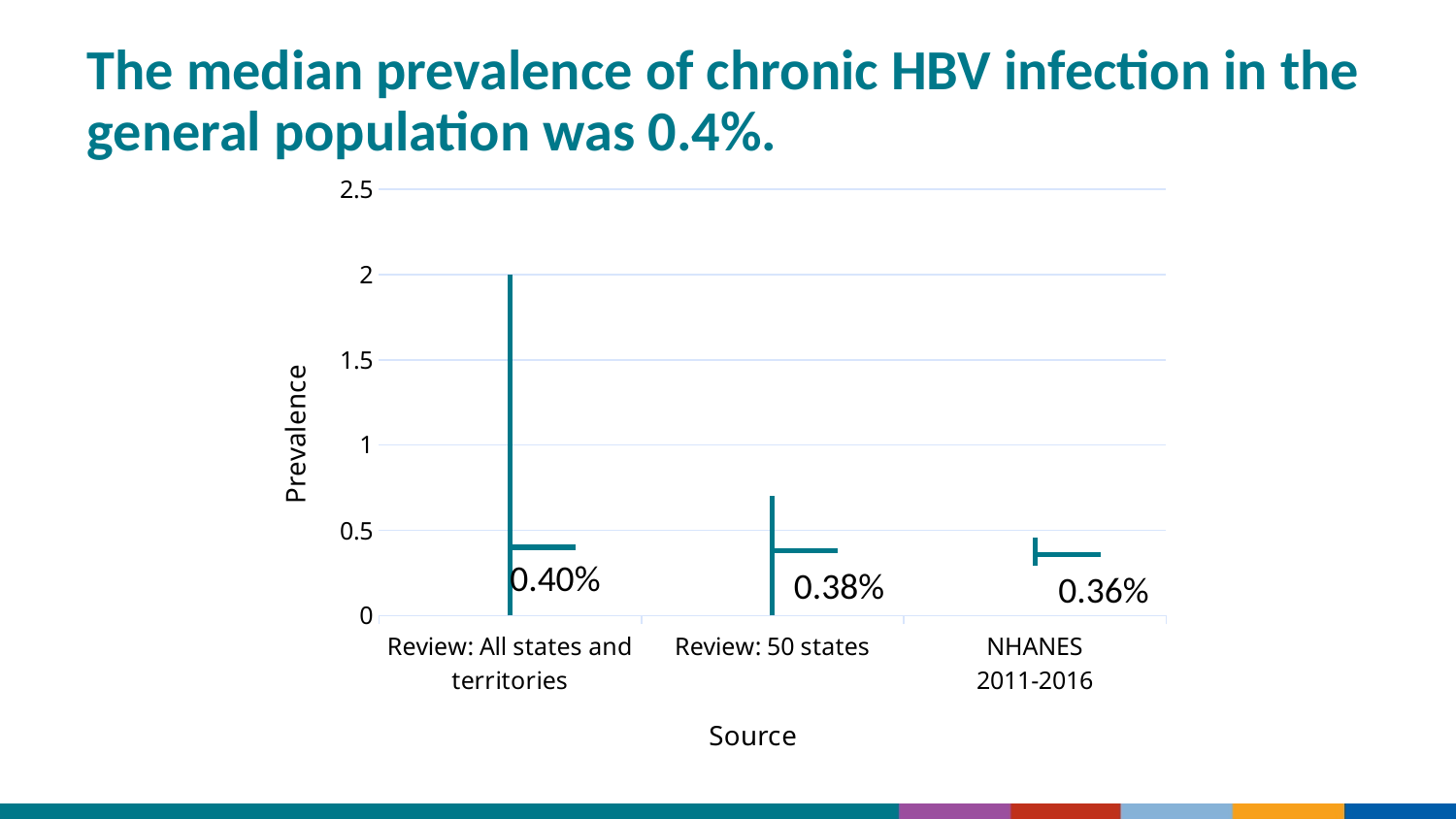
Which source has the lowest labelled median prevalence? NHANES 2011-2016 What is the difference between the labelled values for Review: All states and territories and NHANES 2011-2016? 0.04% What is the median prevalence value labelled for Review: 50 states? 0.38% What is the median prevalence value labelled for NHANES 2011-2016? 0.36% What is the median prevalence value labelled for Review: All states and territories? 0.40% What is the title of the vertical axis of the chart? Prevalence Which source has the highest labelled median prevalence? Review: All states and territories Which has a larger labelled median prevalence, Review: 50 states or NHANES 2011-2016? Review: 50 states How many sources are shown on the x axis of the chart? 3 Is the labelled value for NHANES 2011-2016 greater or less than 0.5? less Do the labelled median prevalence values rise or fall from left to right across the sources? fall What is the difference between the labelled values for Review: All states and territories and Review: 50 states? 0.02%